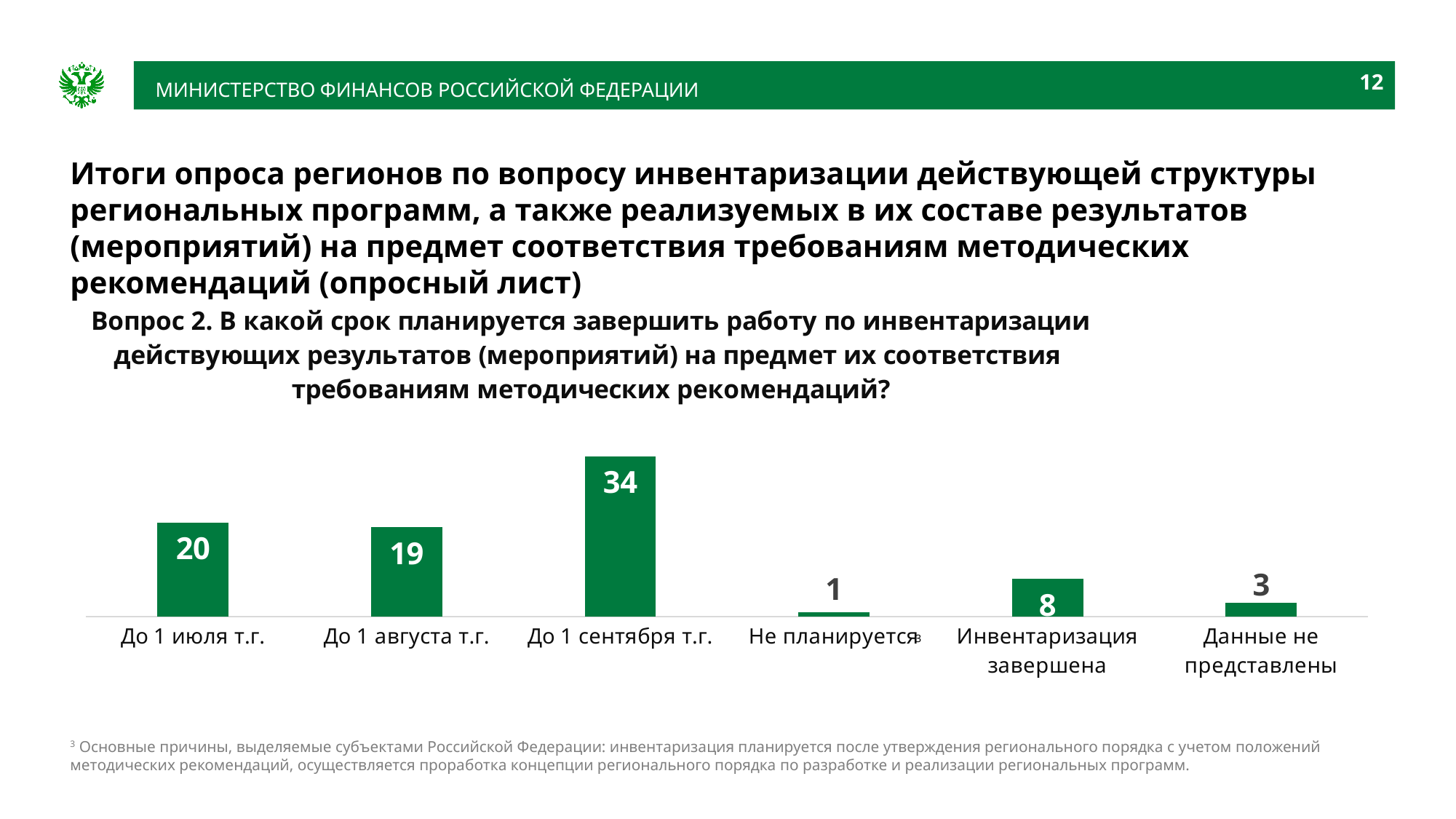
Which category has the lowest value? Не планируется What is the total of all values shown in the chart? 85 Which is larger, the value for "До 1 июля т.г." or "До 1 августа т.г."? До 1 июля т.г. What is the value for "Данные не представлены"? 3 What is the value for "До 1 июля т.г."? 20 What kind of chart is shown on the slide? Bar chart Which category has the highest value? До 1 сентября т.г. What is the value for "До 1 сентября т.г."? 34 How many categories are shown in the chart? 6 What is the value for "Инвентаризация завершена"? 8 What is the difference between the values for "До 1 сентября т.г." and "До 1 июля т.г."? 14 What colour are the bars in the chart? Green